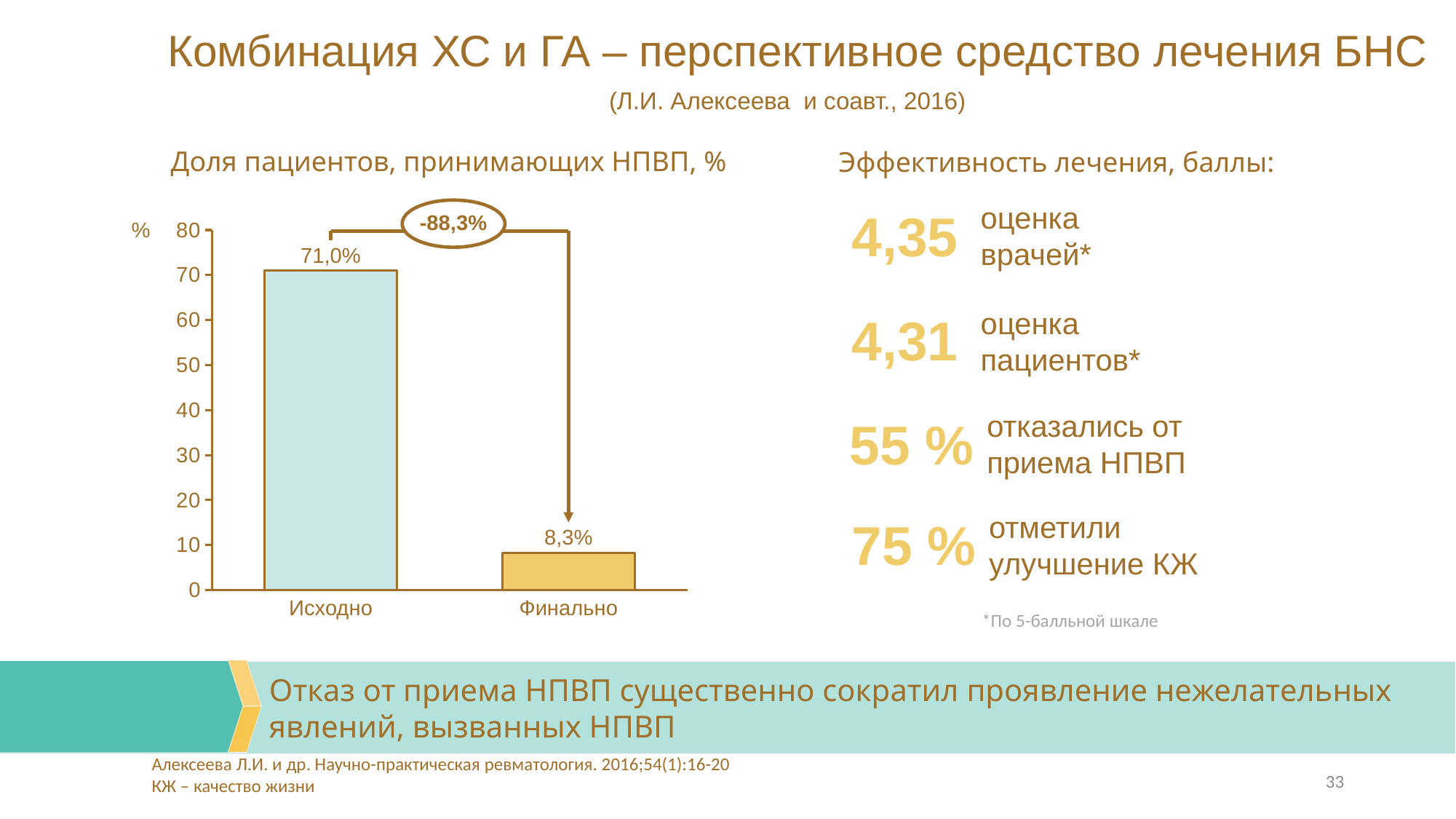
What type of chart is 'Доля пациентов, принимающих НПВП, %'? bar chart Which category has the highest value in the chart 'Доля пациентов, принимающих НПВП, %'? Исходно Is the value for Финально in the chart 'Доля пациентов, принимающих НПВП, %' greater or less than 10? less Which is larger in the chart 'Доля пациентов, принимающих НПВП, %': Исходно or Финально? Исходно What percentage change is shown in the oval annotation above the bars in the chart 'Доля пациентов, принимающих НПВП, %'? -88,3% How many categories are shown in the chart 'Доля пациентов, принимающих НПВП, %'? 2 Do the values rise or fall from Исходно to Финально in the chart 'Доля пациентов, принимающих НПВП, %'? fall What is the difference between the Исходно and Финально values in the chart 'Доля пациентов, принимающих НПВП, %'? 62,7% What is the value for Исходно in the chart 'Доля пациентов, принимающих НПВП, %'? 71,0% What is the value for Финально in the chart 'Доля пациентов, принимающих НПВП, %'? 8,3% Which category has the lowest value in the chart 'Доля пациентов, принимающих НПВП, %'? Финально Is the value for Исходно in the chart 'Доля пациентов, принимающих НПВП, %' greater or less than 60? greater